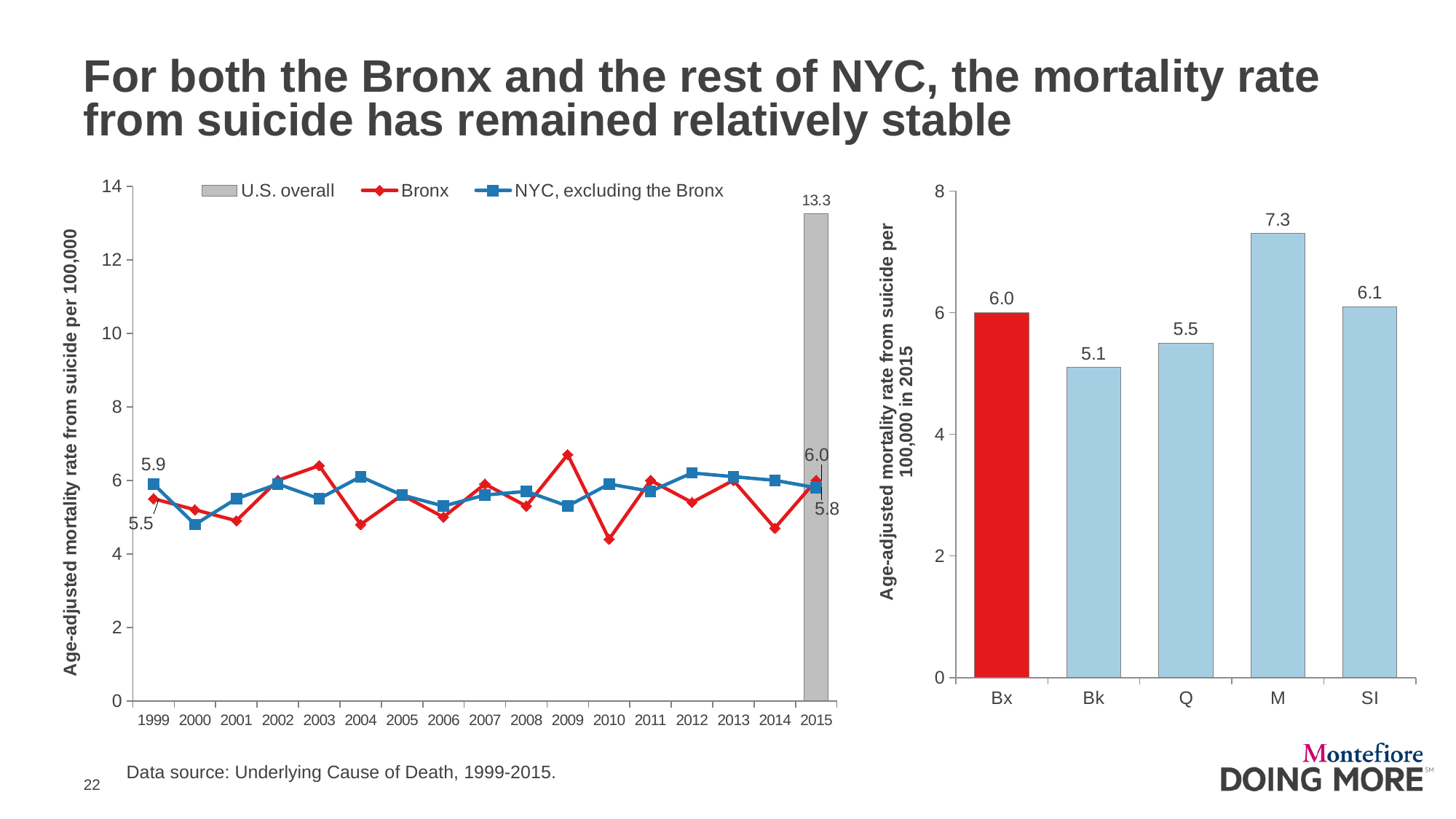
In the left-hand chart, what is the value labelled for NYC, excluding the Bronx in 2015? 5.8 In the right-hand bar chart, what is the value for Bk? 5.1 In the left-hand chart, what is the U.S. overall suicide mortality rate shown for 2015? 13.3 In the right-hand bar chart, which is larger, the value for Q or the value for SI? SI In the right-hand bar chart, which borough has the highest suicide mortality rate in 2015? M In the right-hand bar chart, which borough has the lowest suicide mortality rate in 2015? Bk How many series does the legend of the left-hand chart list? 3 In the right-hand bar chart, what is the difference between the values for M and Bk? 2.2 In the left-hand chart, is the Bronx value for 2010 greater or less than 6? less In the left-hand chart, what is the Bronx value labelled for 1999? 5.5 How many boroughs are shown in the right-hand bar chart? 5 In the right-hand bar chart, what is the age-adjusted suicide mortality rate for M in 2015? 7.3